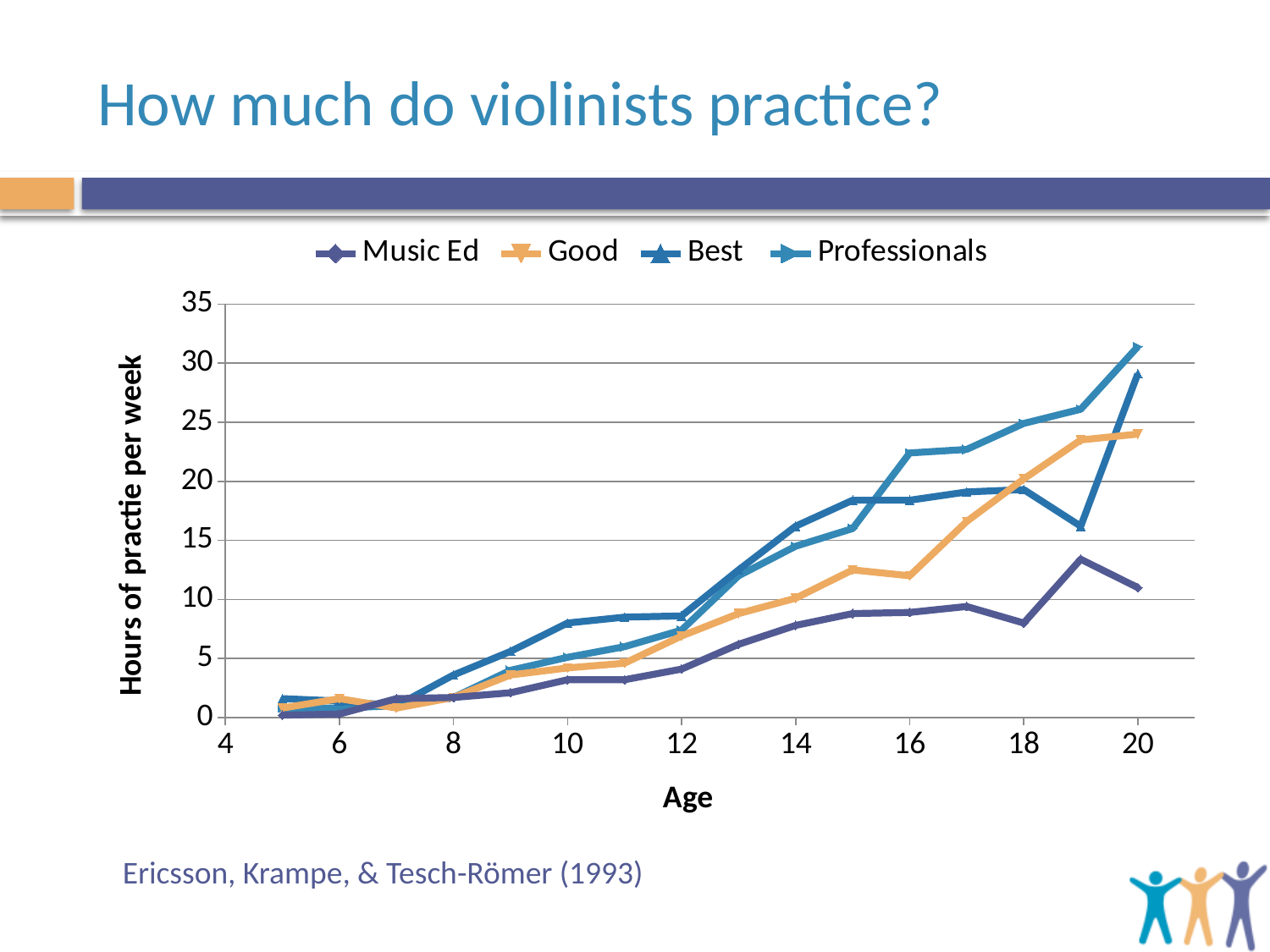
Which series has the lowest value at age 20? Music Ed At age 19, which is larger: the value for Good or the value for Best? Good What is the title of the x axis? Age Do the values for Professionals generally rise or fall as age increases? rise What kind of chart is shown on the slide? line chart At age 16, which is larger: the value for Professionals or the value for Best? Professionals How many series does the legend list? 4 Is the value for Best at age 19 greater or less than 20? less Is the value for Music Ed at age 20 greater or less than 15? less Is the value for Professionals at age 16 greater or less than 20? greater Which series has the highest value at age 20? Professionals